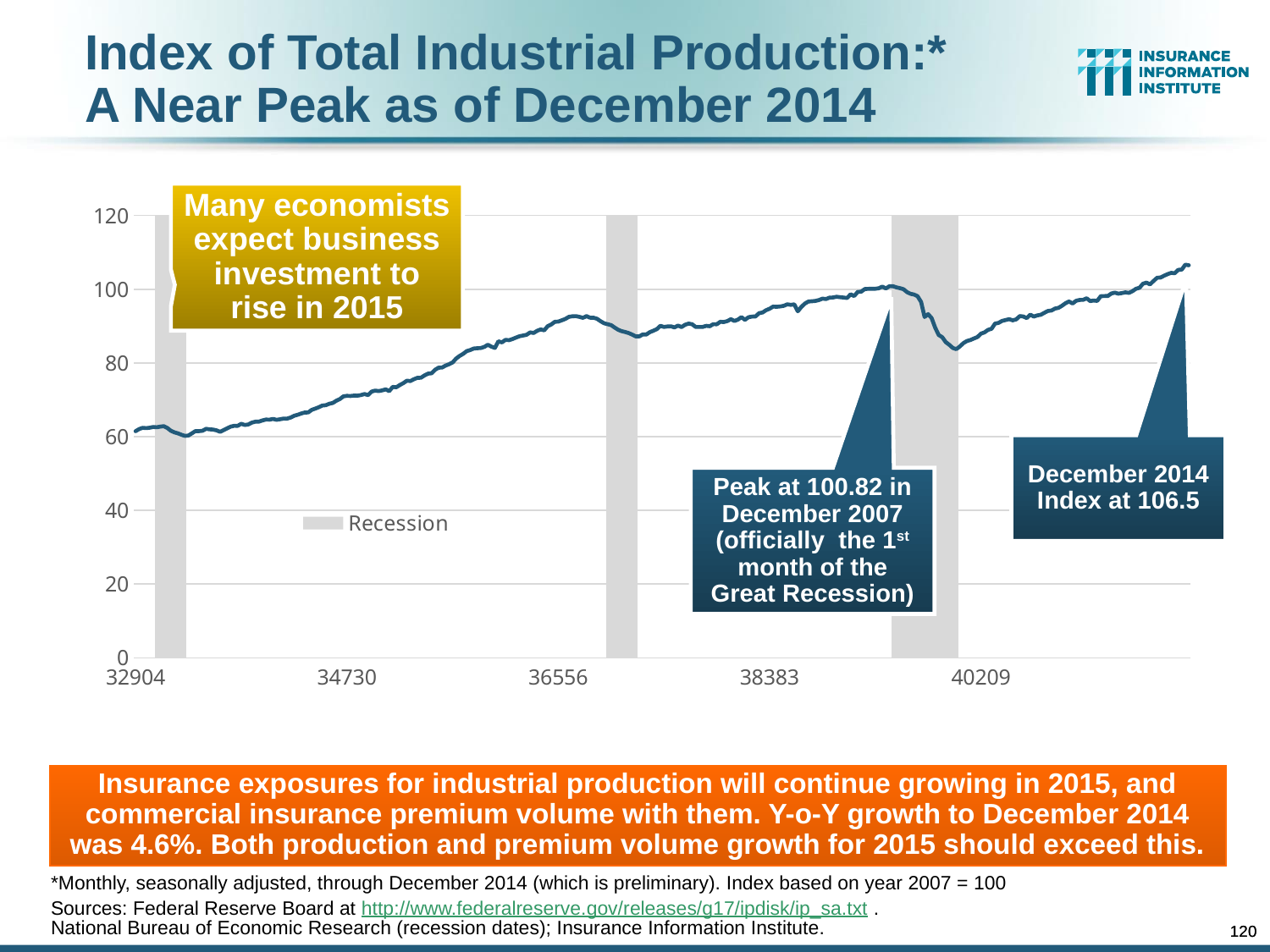
Is the index value at the x-axis label 40209 greater or less than 100? less What is the highest value labelled on the y-axis? 120 What was the peak value of the index in December 2007? 100.82 What is the only entry shown in the chart's legend? Recession Which is larger: the index in December 2014 or the peak in December 2007? December 2014 How many grey shaded recession bands appear on the chart? 3 Over the whole period shown, does the index generally rise or fall from left to right? rise What kind of chart is shown on the slide? line chart What was the Index of Total Industrial Production in December 2014? 106.5 How much higher is the December 2014 index (106.5) than the December 2007 peak (100.82)? 5.68 Is the index value at the far left of the chart (x-axis label 32904) greater or less than 80? less Is the index value at the x-axis label 36556 greater or less than 80? greater